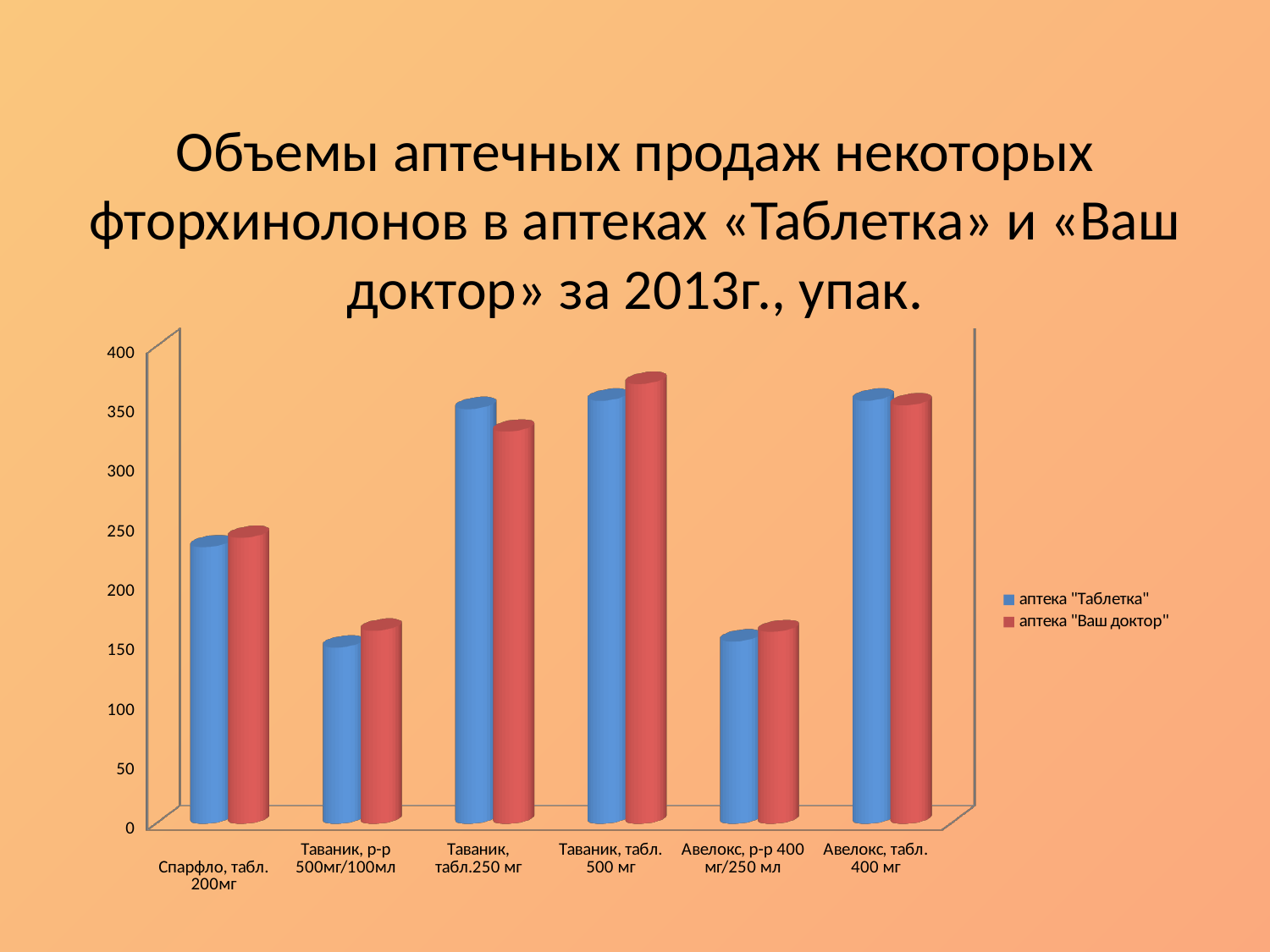
Is the value for Авелокс, р-р 400 мг/250 мл in аптека "Ваш доктор" greater or less than 200? less How many product categories are shown on the x axis of the chart? 6 Is the value for Спарфло, табл. 200мг in аптека "Таблетка" greater or less than 200? greater For Таваник, табл.250 мг, which pharmacy has the larger value: аптека "Таблетка" or аптека "Ваш доктор"? аптека "Таблетка" Which pharmacy series is drawn in red in the chart? аптека "Ваш доктор" Is the value for Таваник, р-р 500мг/100мл in аптека "Таблетка" greater or less than 200? less Which pharmacy series is drawn in blue in the chart? аптека "Таблетка" What kind of chart is shown on the slide? bar chart How many series does the chart legend list? 2 In аптека "Ваш доктор", which has the larger value: Таваник, р-р 500мг/100мл or Авелокс, табл. 400 мг? Авелокс, табл. 400 мг